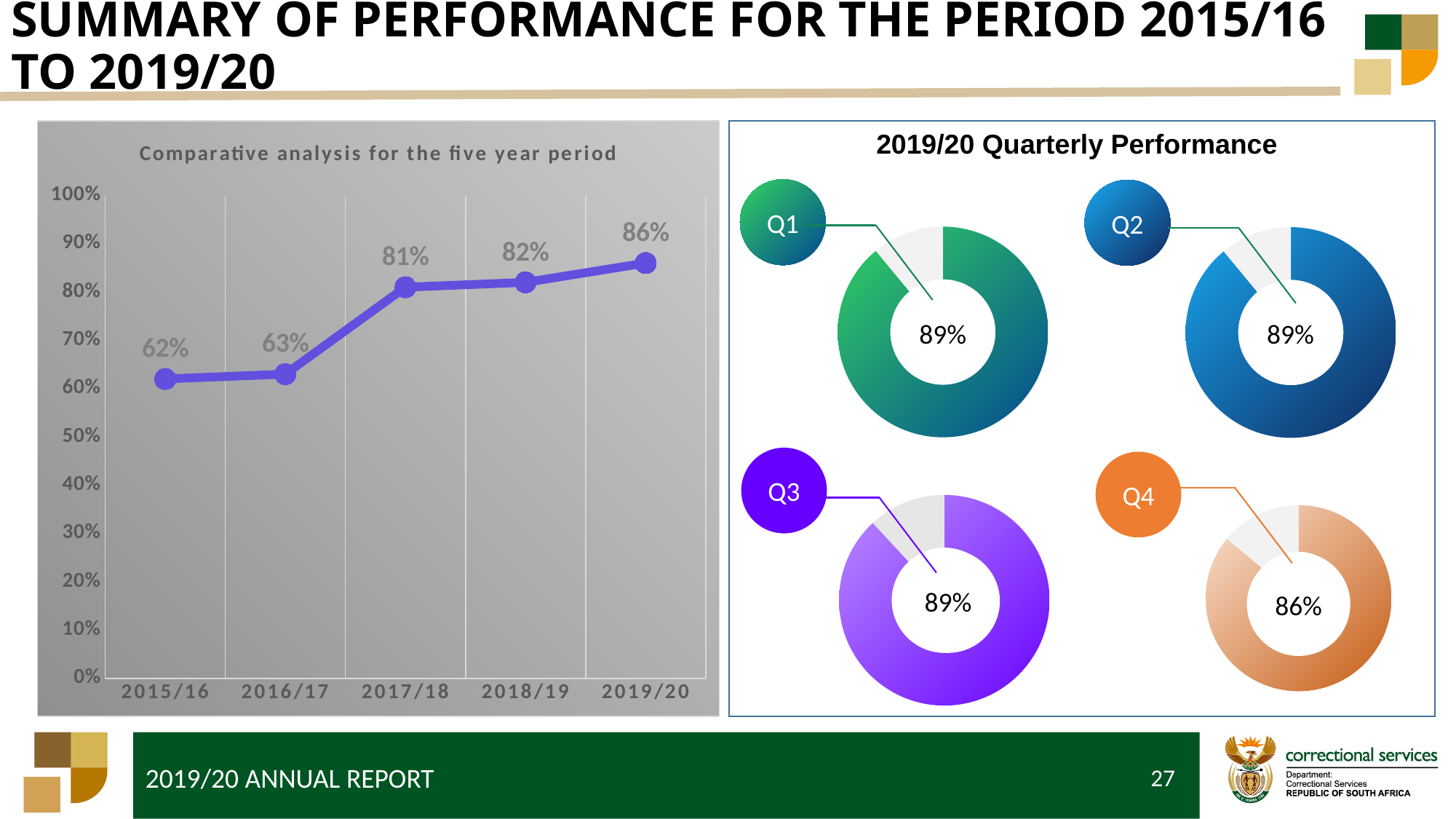
In the 'Comparative analysis for the five year period' chart, do the values rise or fall from 2015/16 to 2019/20? rise In the 'Comparative analysis for the five year period' chart, which year has the lowest value? 2015/16 In the 'Comparative analysis for the five year period' chart, which year has the highest value? 2019/20 In the '2019/20 Quarterly Performance' chart, which is larger, the value for Q1 or the value for Q4? Q1 In the 'Comparative analysis for the five year period' chart, is the value for 2018/19 greater or less than 70%? greater In the 'Comparative analysis for the five year period' chart, what is the value for 2017/18? 81% What kind of chart is the 'Comparative analysis for the five year period' chart? line chart In the '2019/20 Quarterly Performance' chart, how many quarters are shown? 4 In the 'Comparative analysis for the five year period' chart, what is the value for 2015/16? 62% In the 'Comparative analysis for the five year period' chart, how many years are plotted? 5 In the '2019/20 Quarterly Performance' chart, what is the value for Q4? 86% In the 'Comparative analysis for the five year period' chart, what is the difference between the values for 2019/20 and 2015/16? 24%